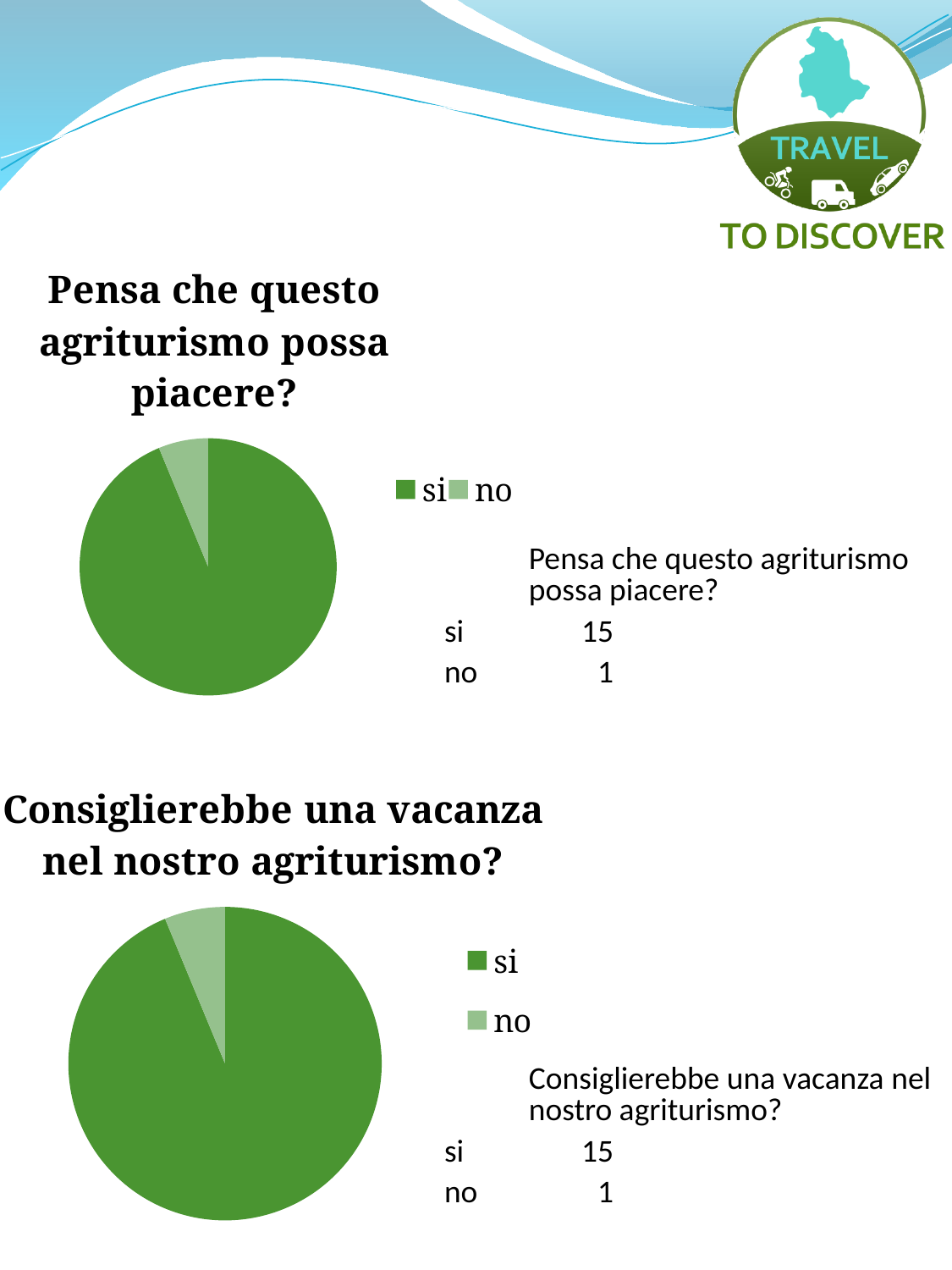
In the chart titled "Pensa che questo agriturismo possa piacere?", what is the difference between the values for "si" and "no"? 14 How many categories does the chart titled "Consiglierebbe una vacanza nel nostro agriturismo?" show? 2 In the bottom chart, which is larger, the value for "si" or the value for "no"? si In the chart titled "Pensa che questo agriturismo possa piacere?", what is the value for "no"? 1 In the chart titled "Pensa che questo agriturismo possa piacere?", what is the value for "si"? 15 In the chart titled "Consiglierebbe una vacanza nel nostro agriturismo?", what is the value for "no"? 1 In the bottom chart, which category has the smallest slice? no In the chart titled "Consiglierebbe una vacanza nel nostro agriturismo?", what is the value for "si"? 15 In the top chart, what share of the total does the "si" slice represent? 93.75% What type of chart is the top chart on the slide? pie chart What entries does the legend of the bottom chart list? si, no In the top chart, which category has the largest slice? si